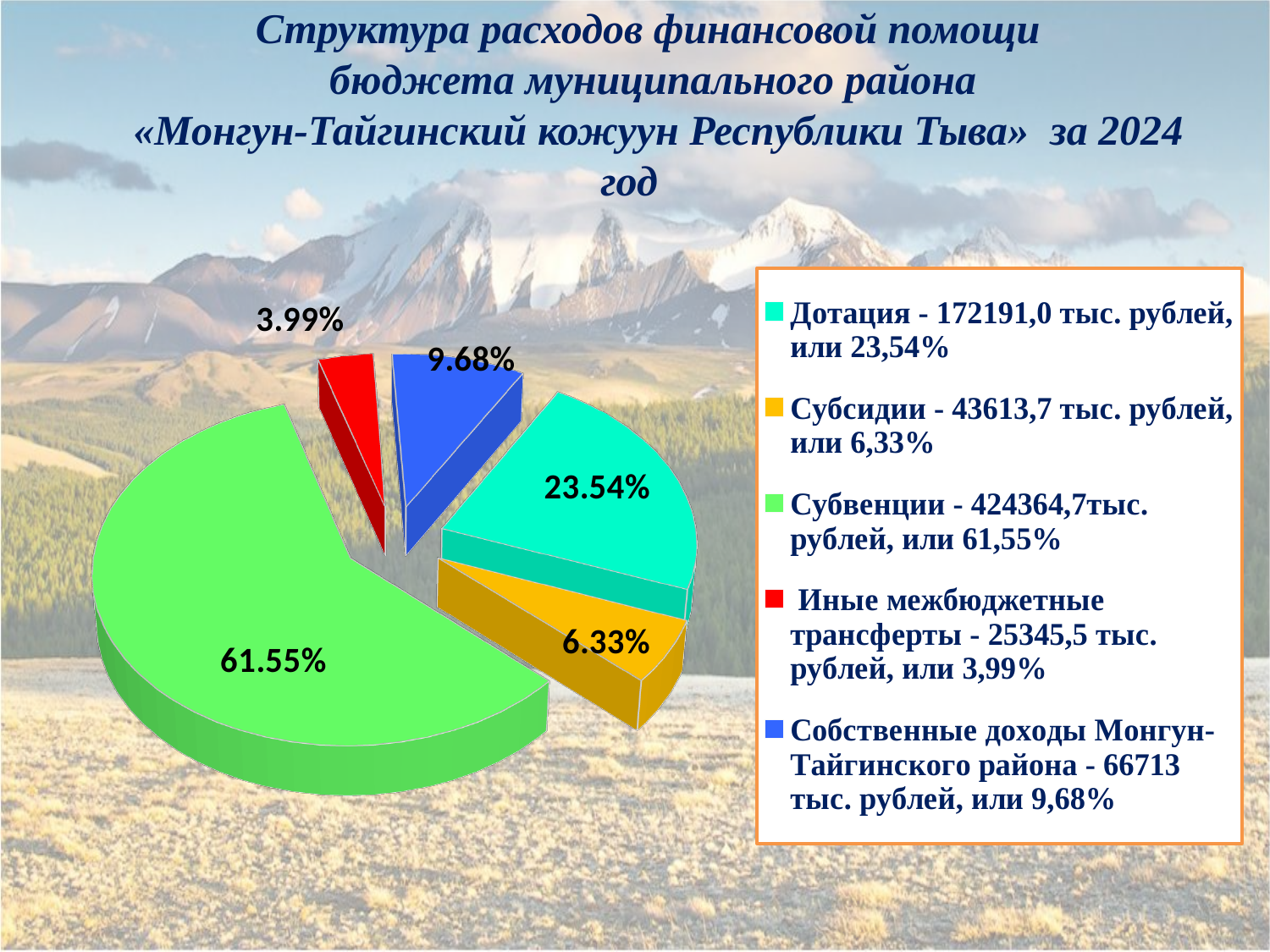
What share of the pie does Субвенции take? 61.55% How many entries does the legend list? 5 What share of the pie does Субсидии take? 6.33% What kind of chart is shown on the slide? pie chart Which category has the largest slice of the pie? Субвенции What share of the pie does Дотация take? 23.54% Which category has the smallest slice of the pie? Иные межбюджетные трансферты How many slices does the pie chart have? 5 Which is larger: the share for Дотация or the share for Собственные доходы Монгун-Тайгинского района? Дотация What is the value for Собственные доходы Монгун-Тайгинского района in thousand rubles, according to the legend? 66713 тыс. рублей What is the value for Субсидии in thousand rubles, according to the legend? 43613,7 тыс. рублей